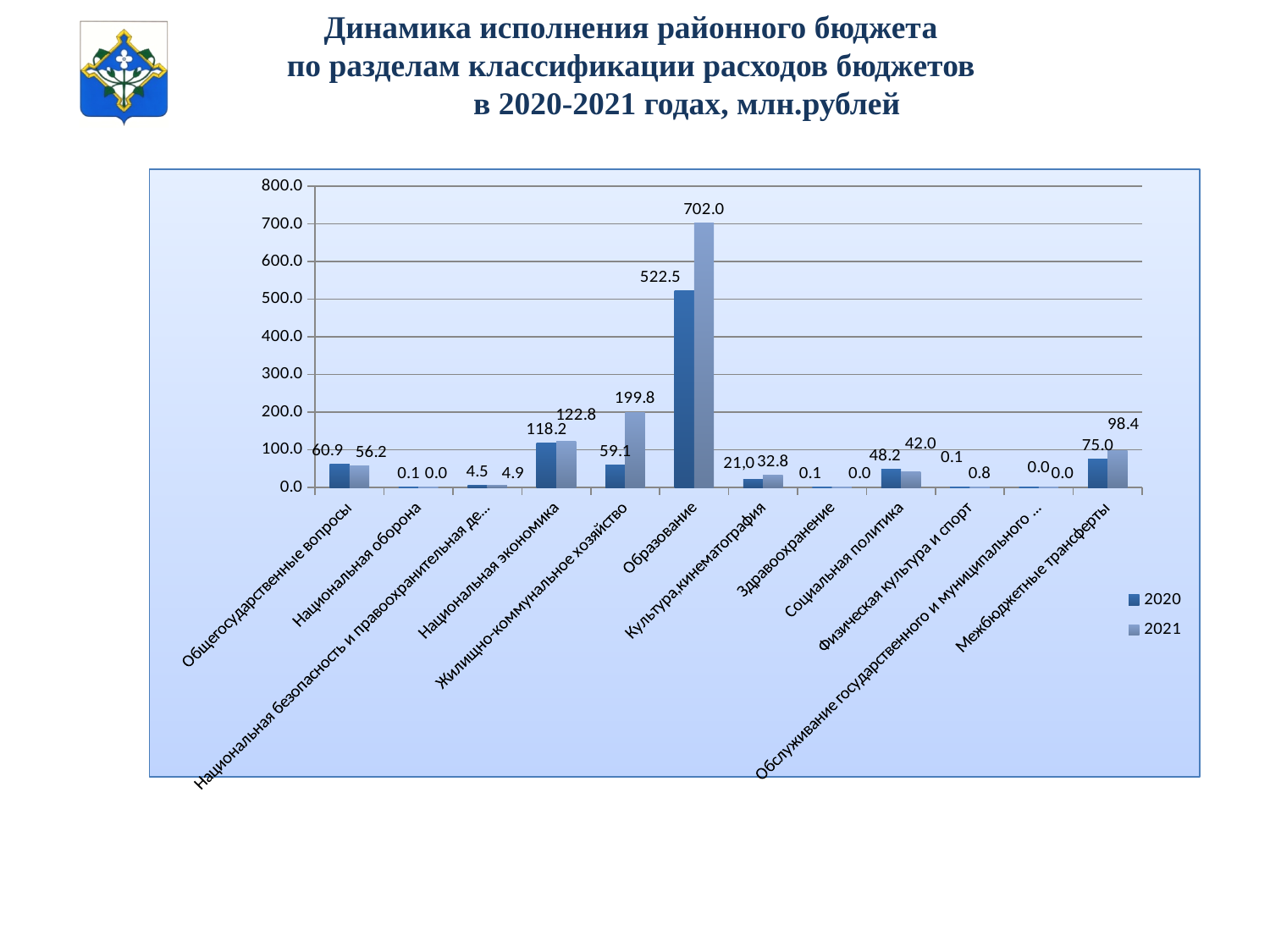
Is the 2021 value for Национальная экономика greater or less than 100.0? greater What is the difference between the 2021 and 2020 values for Жилищно-коммунальное хозяйство? 140.7 Which is larger for Социальная политика: the 2020 value or the 2021 value? 2020 What kind of chart is shown on the slide? Bar chart What are the two series listed in the legend? 2020 and 2021 What is the value for Межбюджетные трансферты in 2021? 98.4 What is the difference between the 2021 and 2020 values for Образование? 179.5 Which category has the highest value in 2020? Образование How many series does the legend list? 2 What is the value for Жилищно-коммунальное хозяйство in 2020? 59.1 How many categories are shown on the x axis? 12 What is the value for Образование in 2021? 702.0